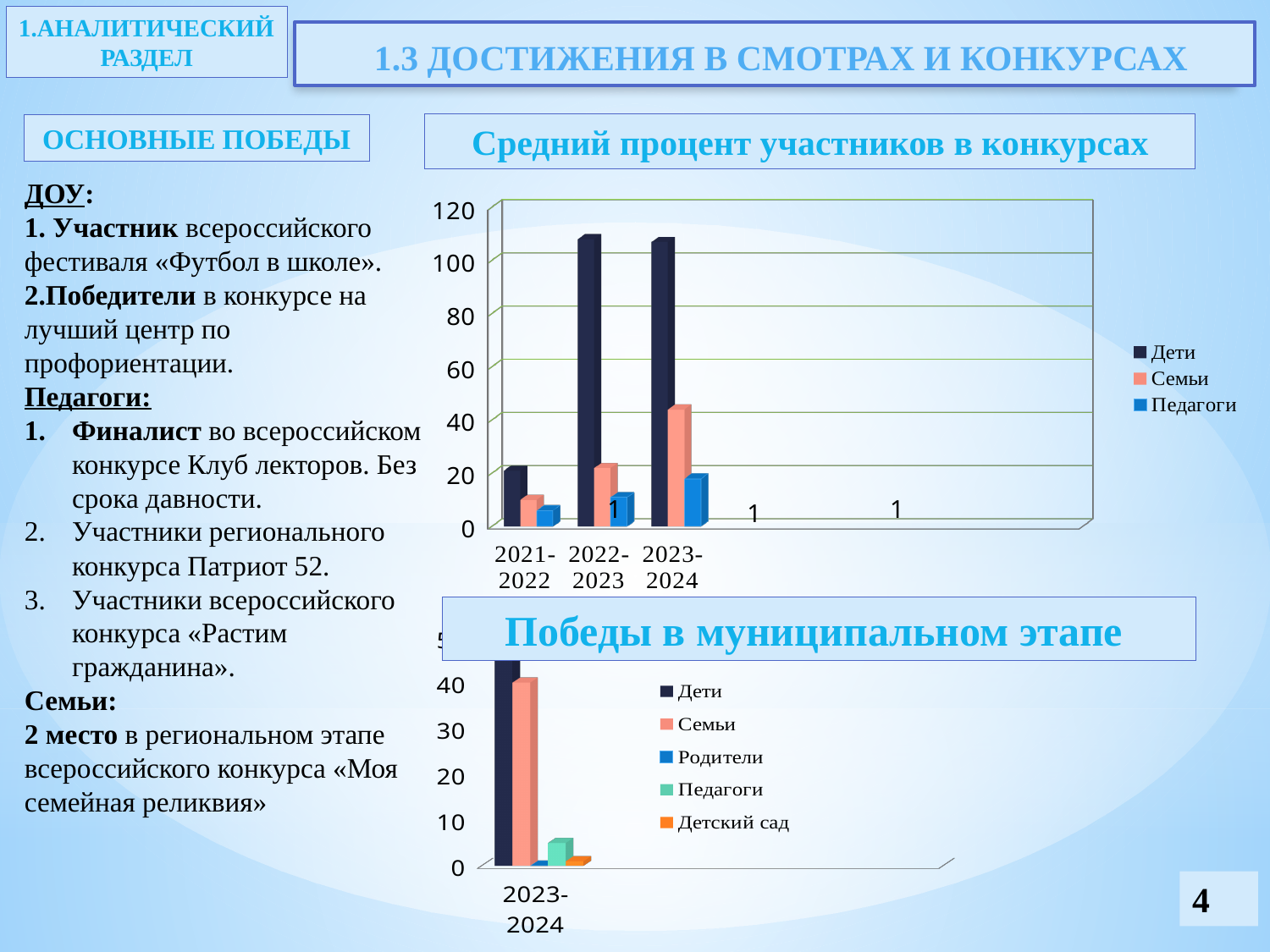
In the chart "Средний процент участников в конкурсах", is the value for Дети in 2021-2022 greater or less than 40? less In the chart "Средний процент участников в конкурсах", is the value for Семьи in 2023-2024 greater or less than 40? greater In the chart "Победы в муниципальном этапе", is the value for Семьи greater or less than 30? greater How many categories are shown on the x axis of the chart "Средний процент участников в конкурсах"? 3 In the chart "Победы в муниципальном этапе", which series has the highest value for 2023-2024? Дети In the chart "Средний процент участников в конкурсах", do the values for Семьи rise or fall from 2021-2022 to 2023-2024? rise How many series does the legend of the chart "Средний процент участников в конкурсах" list? 3 How many series does the legend of the chart "Победы в муниципальном этапе" list? 5 What kind of chart is the chart titled "Средний процент участников в конкурсах"? bar chart In the chart "Средний процент участников в конкурсах", which series has the lowest value in 2021-2022? Педагоги In the chart "Средний процент участников в конкурсах", which series has the highest value in 2023-2024? Дети